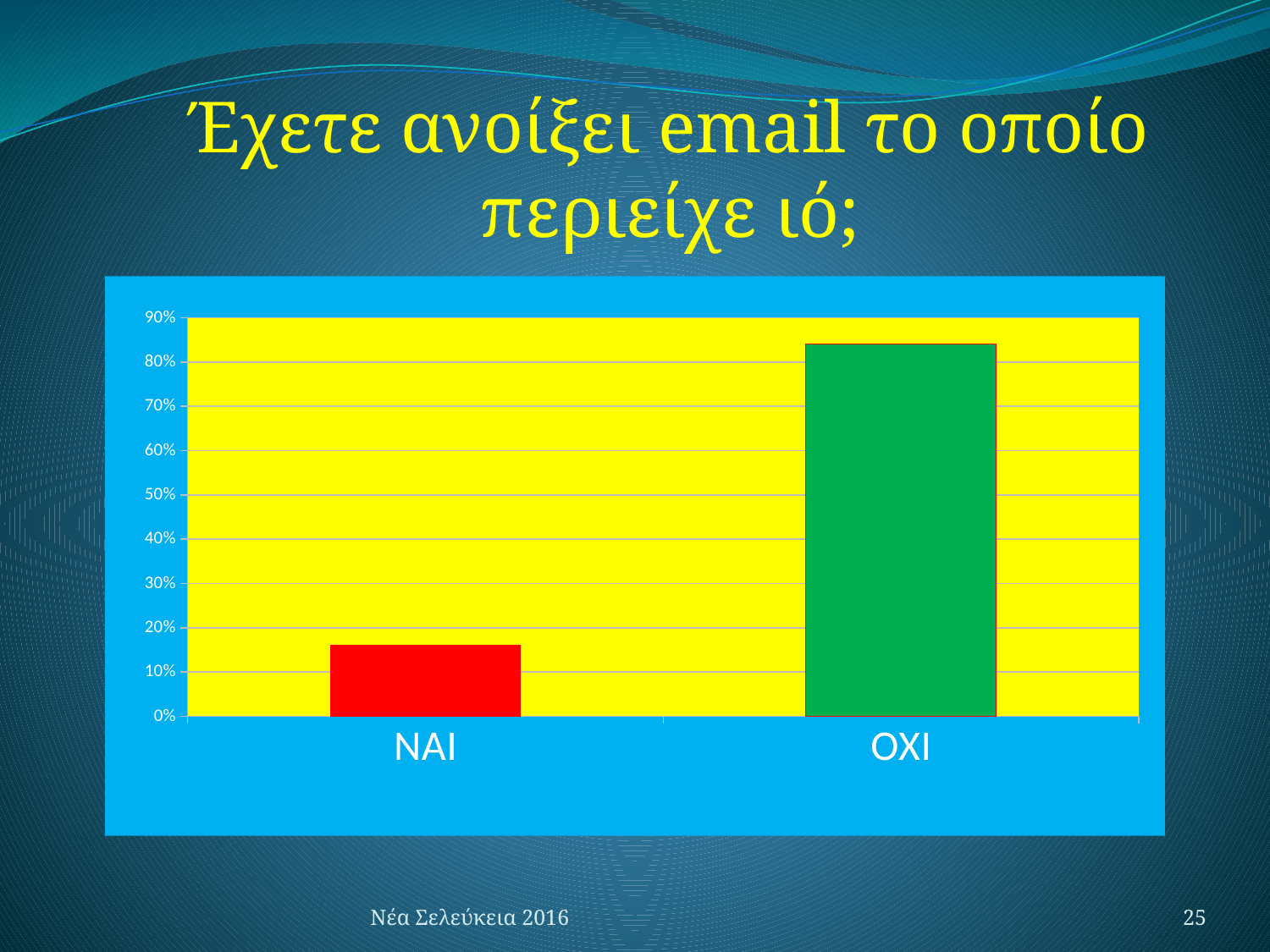
What kind of chart is shown on the slide? bar chart Is the value for ΝΑΙ greater or less than 10%? greater Is the value for ΝΑΙ greater or less than 20%? less What colour is the bar for ΟΧΙ? green Is the value for ΟΧΙ greater or less than 80%? greater Which category has the highest bar in the chart? ΟΧΙ How many categories are shown on the x axis of the chart? 2 Which is larger, the value for ΝΑΙ or the value for ΟΧΙ? ΟΧΙ Which category has the lowest bar in the chart? ΝΑΙ What is the highest value shown on the y axis of the chart? 90%